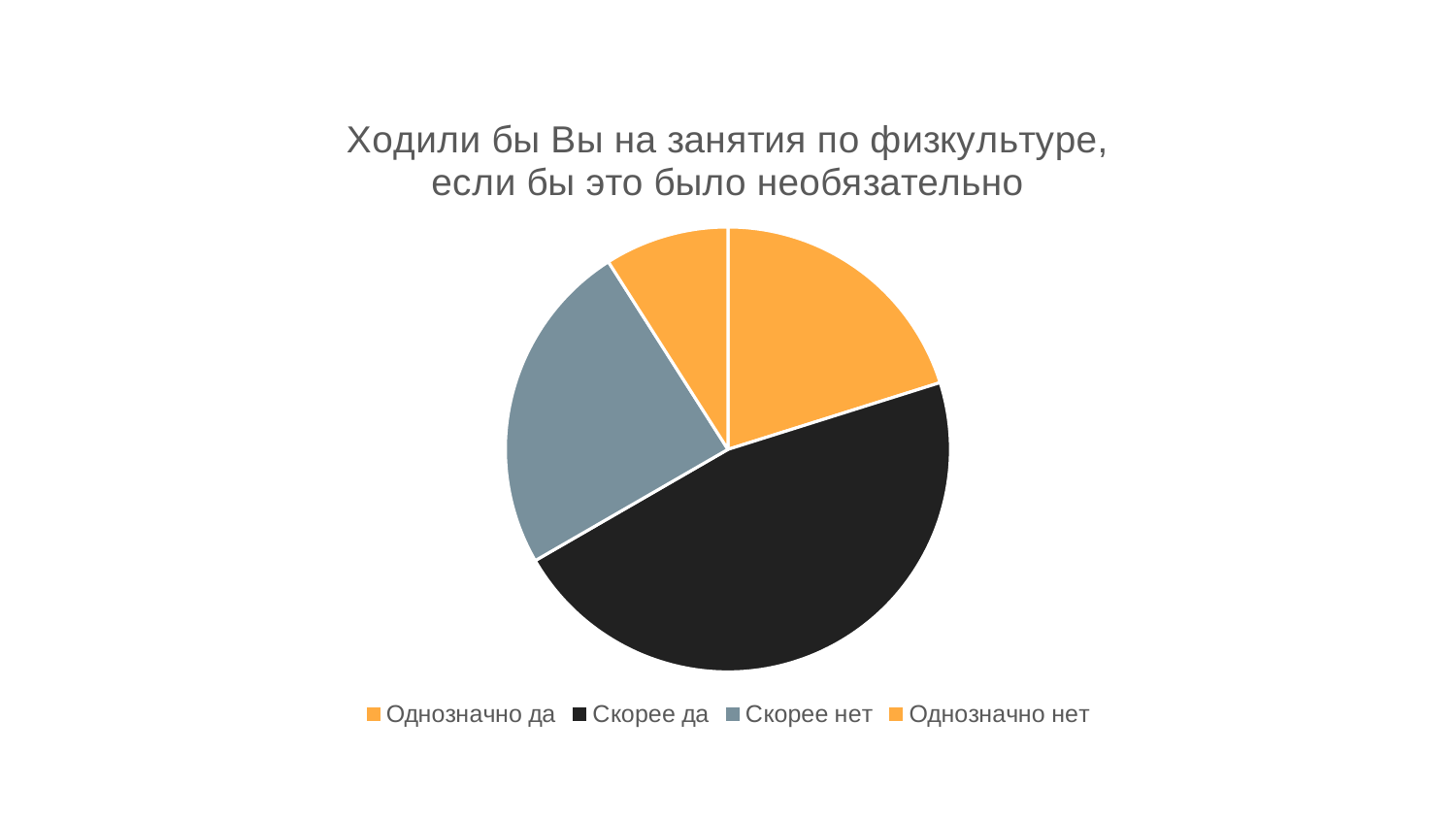
Which slice is larger, "Скорее да" or "Скорее нет"? Скорее да Which category has the smallest slice of the pie? Однозначно нет Which slice is larger, "Однозначно да" or "Однозначно нет"? Однозначно да Which slice is larger, "Скорее да" or "Однозначно да"? Скорее да What kind of chart is shown on the slide? pie chart How many slices does the pie chart have? 4 How many entries does the legend list? 4 What is the title of the chart? Ходили бы Вы на занятия по физкультуре, если бы это было необязательно Which category has the largest slice of the pie? Скорее да What colour is the "Скорее да" slice? black